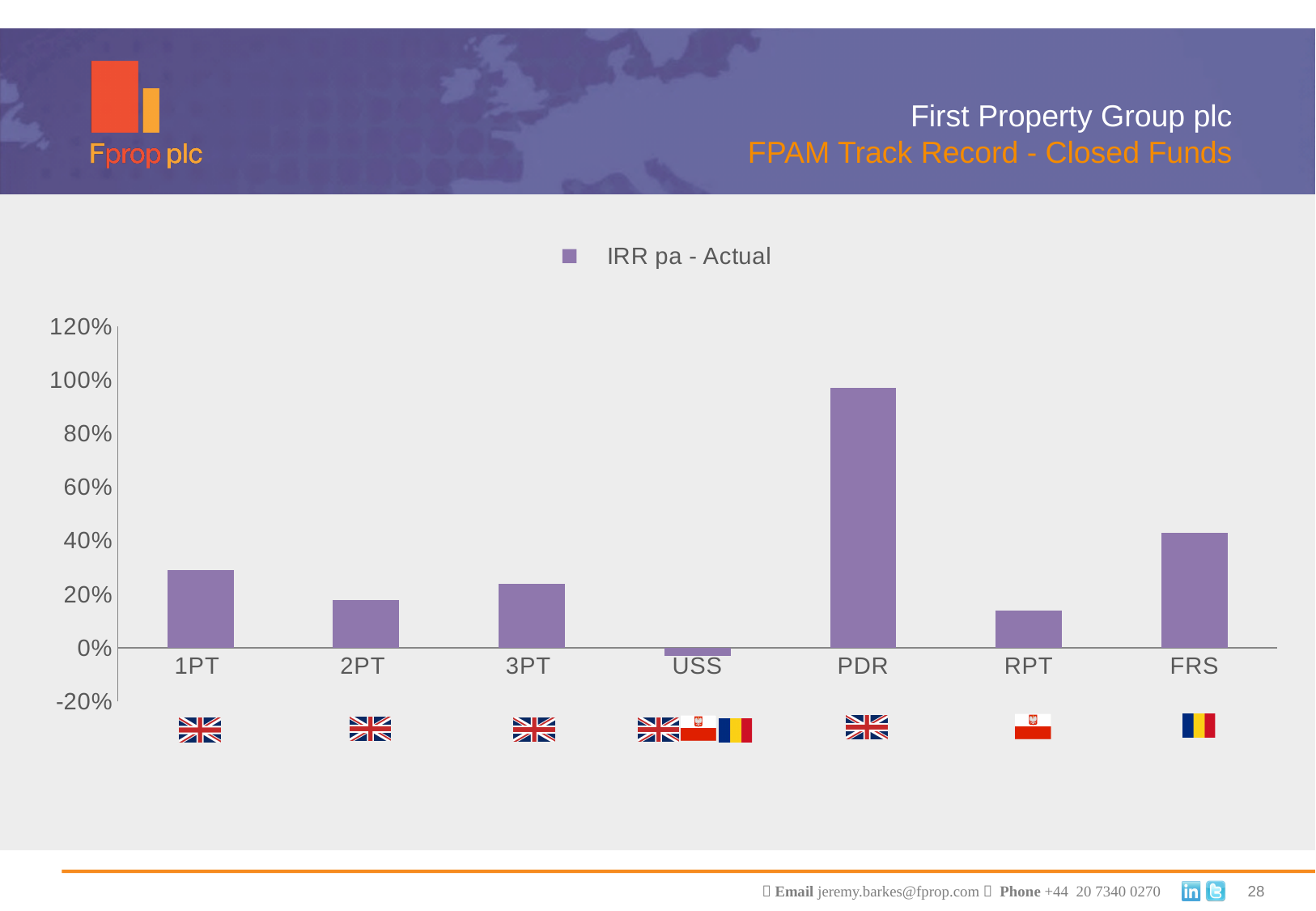
Which has a larger IRR pa - Actual value, 1PT or 2PT? 1PT What type of chart is shown on the slide? bar chart Is the value for RPT greater or less than 20%? less Is the value for FRS greater or less than 40%? greater What is the name of the series shown in the chart legend? IRR pa - Actual Which category has the highest IRR pa - Actual value? PDR Is the value for USS greater or less than 0%? less How many series does the chart legend list? 1 Which category has the lowest IRR pa - Actual value? USS How many categories are shown on the x axis of the chart? 7 Which has a larger IRR pa - Actual value, FRS or 3PT? FRS